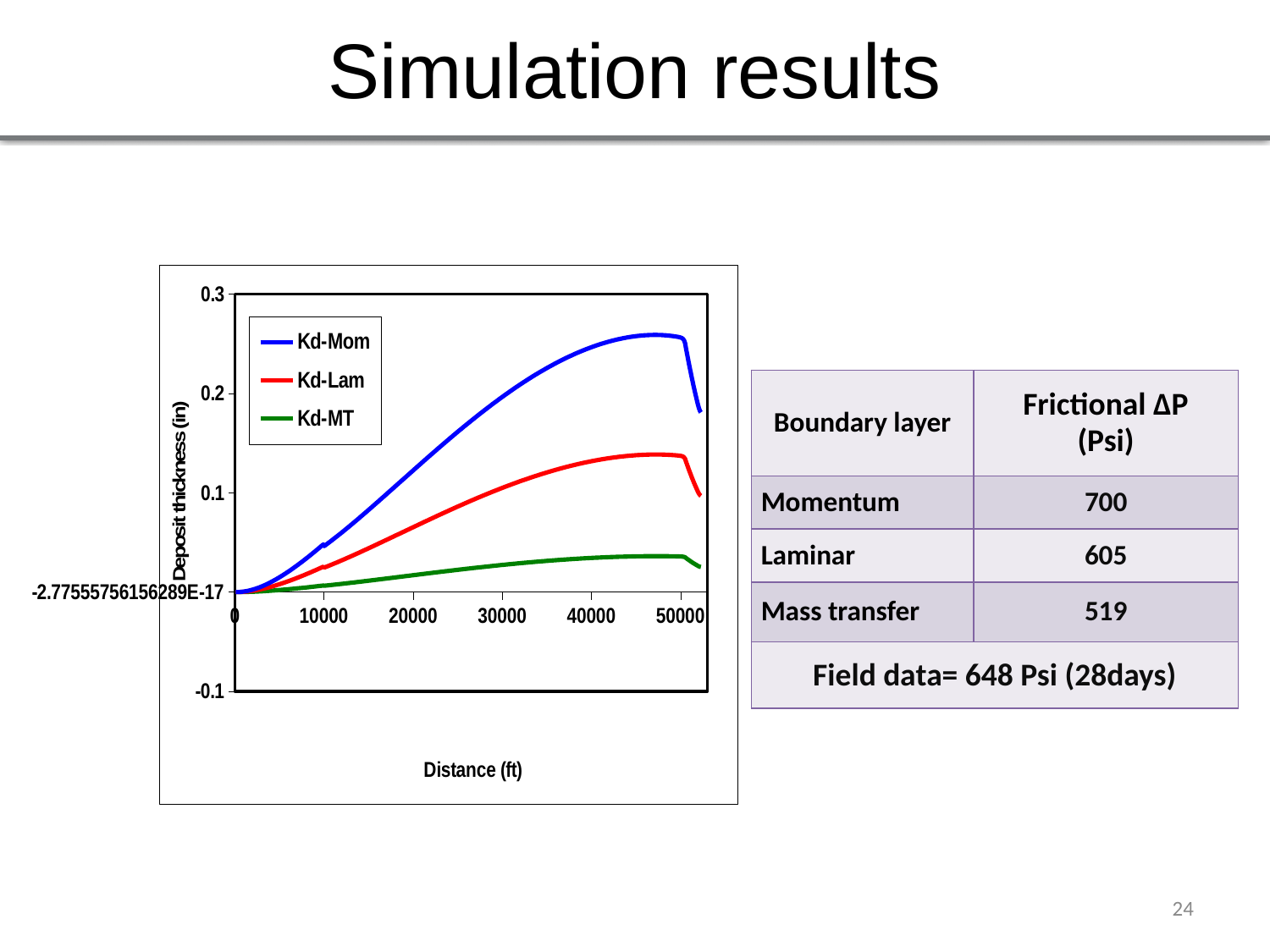
Does the Kd-Mom series rise or fall as distance increases from 0 to 40000 ft? rise Is the value of the Kd-Lam series at 40000 ft greater or less than 0.1? greater Is the value of the Kd-MT series at 40000 ft greater or less than 0.1? less What colour is the Kd-Lam series drawn in? red What kind of chart is shown on the slide? line chart What is the label of the x axis of the chart? Distance (ft) Which series has the lowest deposit thickness across the chart? Kd-MT Is the peak value of the Kd-Mom series greater or less than 0.2? greater At a distance of 30000 ft, which series has the larger deposit thickness, Kd-Mom or Kd-Lam? Kd-Mom How many series does the chart legend list? 3 Which series reaches the highest deposit thickness on the chart? Kd-Mom